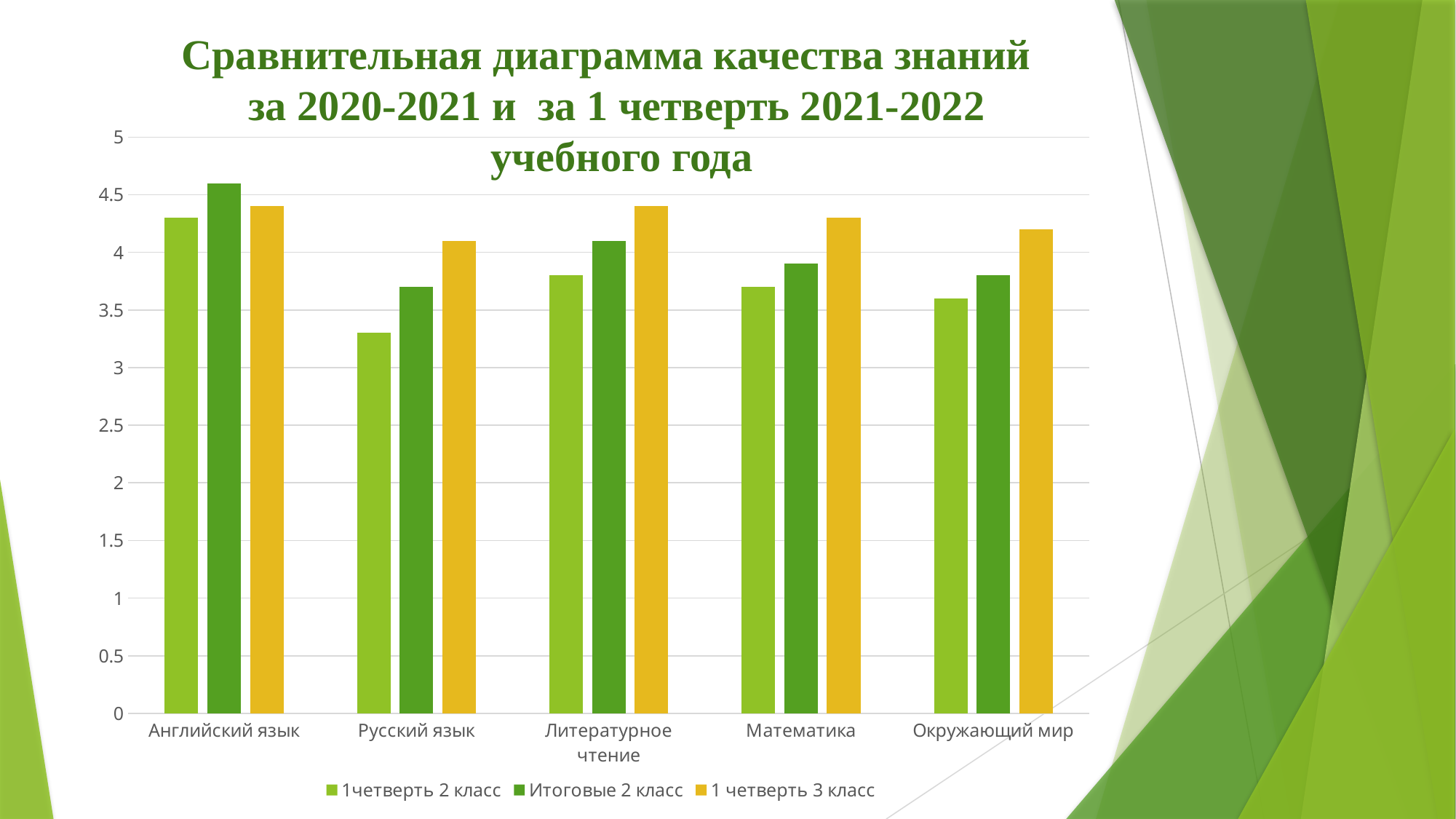
Which category has the lowest value for the series '1четверть 2 класс'? Русский язык What colour are the bars for the series '1 четверть 3 класс'? yellow Is the value for Литературное чтение in the series '1 четверть 3 класс' greater or less than 4? greater For Русский язык, which is larger: the value for '1четверть 2 класс' or for '1 четверть 3 класс'? 1 четверть 3 класс Which category has the highest value for the series '1четверть 2 класс'? Английский язык What kind of chart is shown on the slide? bar chart Is the value for Русский язык in the series '1четверть 2 класс' greater or less than 3.5? less Which category has the highest value for the series 'Итоговые 2 класс'? Английский язык How many subject categories are shown on the x axis? 5 How many series does the legend list? 3 For Литературное чтение, which is larger: the value for '1четверть 2 класс' or for '1 четверть 3 класс'? 1 четверть 3 класс Is the value for Окружающий мир in the series '1 четверть 3 класс' greater or less than 4? greater